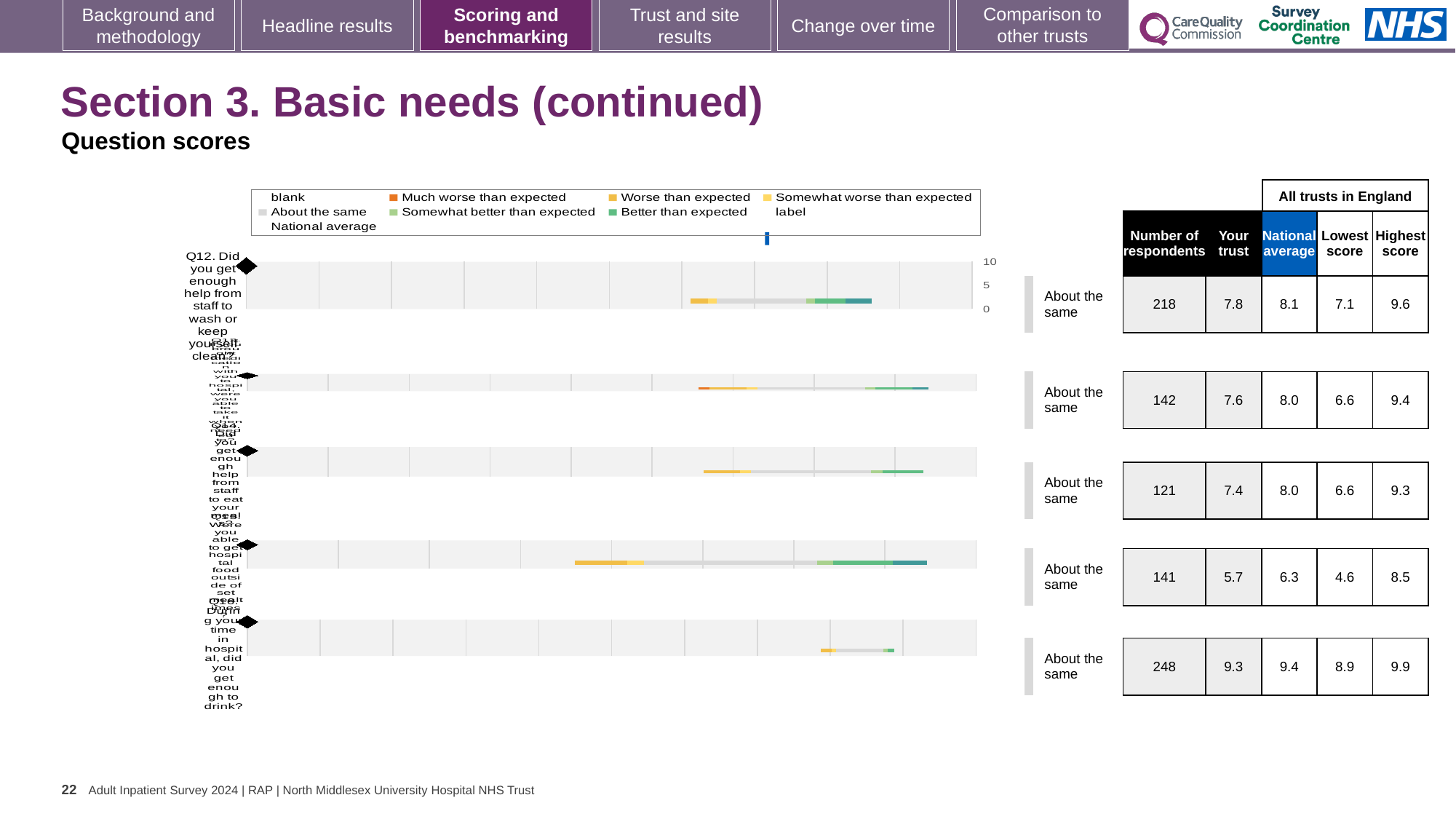
In the table next to the chart, how many respondents are listed for the first row (Q12)? 218 What colour does the legend use for 'Much worse than expected'? orange How many question bars are plotted in the chart? 5 What benchmark category is shown beside every bar in the chart? About the same What is the label of the first (top) question in the chart? Q12. Did you get enough help from staff to wash or keep yourself clean? In the table next to the chart, what is the 'Your trust' score for the first row (Q12)? 7.8 In the table next to the chart, what is the difference between the national average (8.1) and the trust score (7.8) for the first row? 0.3 In the table next to the chart, what is the lowest 'Your trust' score shown? 5.7 In the table next to the chart, which row has the highest 'Your trust' score, and what is it? the last row, 9.3 What kind of chart is shown on the slide? bar chart How many entries does the chart legend list? 9 In the table next to the chart, for the second row, which is larger: the 'Your trust' score or the national average? National average